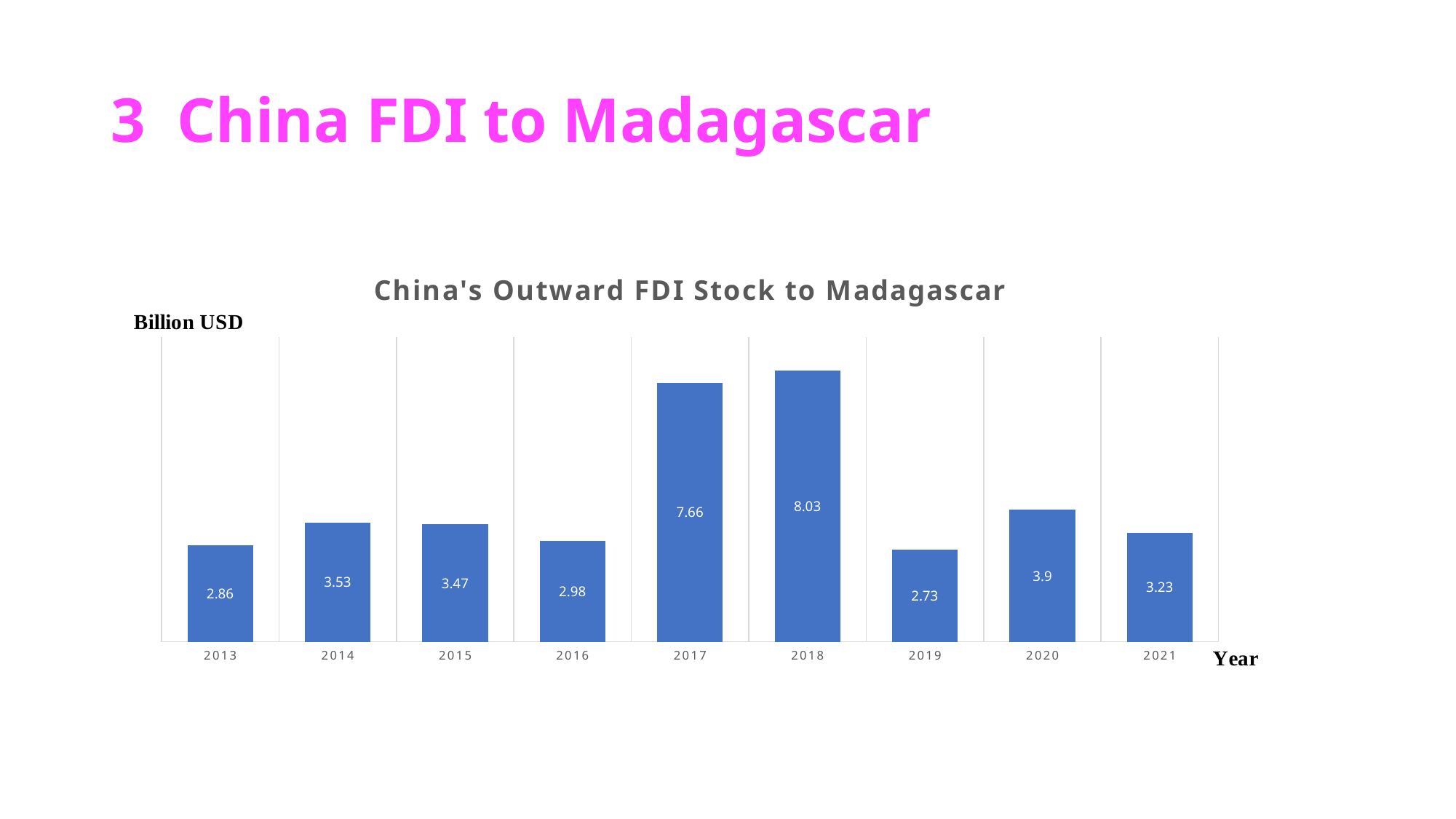
What kind of chart is this? bar chart What is the title of the chart? China's Outward FDI Stock to Madagascar Which year has the lowest value? 2019 What is the value for 2020? 3.9 Which year has the highest value? 2018 What is the difference between the values for 2014 and 2013? 0.67 Which is larger, the value for 2021 or the value for 2016? 2021 What is the value for 2017? 7.66 What is the value for 2013? 2.86 How many years are shown on the x axis? 9 What is the difference between the values for 2018 and 2017? 0.37 Do the values rise or fall from 2018 to 2019? fall